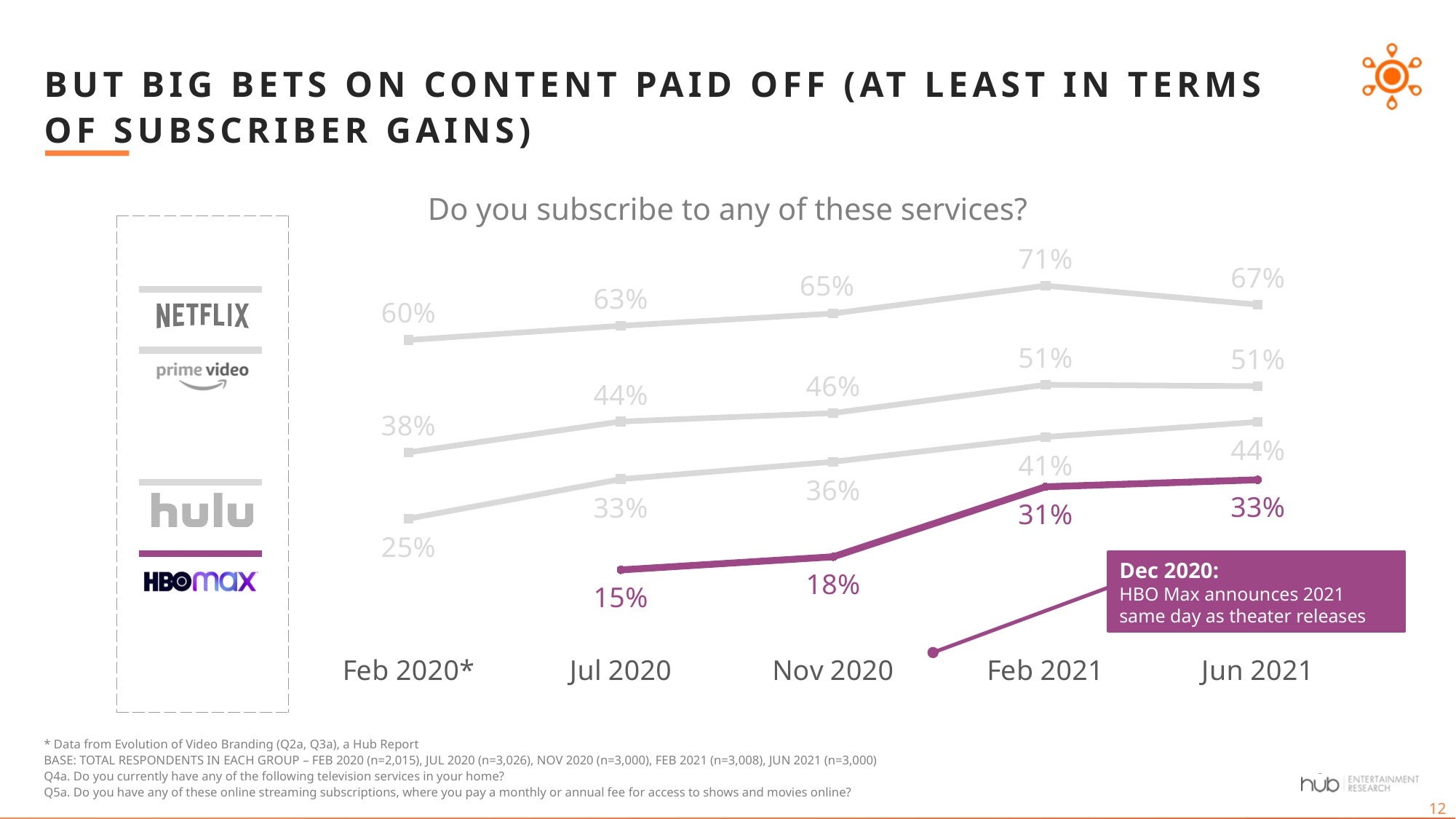
What kind of chart is shown on the slide? line chart What percentage of respondents subscribed to HBO Max in Jul 2020? 15% By how many percentage points did HBO Max's subscription rate increase from Nov 2020 to Feb 2021? 13 percentage points At which time point did Netflix reach its highest subscription rate? Feb 2021 How many services (series) does the legend on the left list? 4 How many time points are shown on the x axis of the chart? 5 What was the Netflix subscription rate in Feb 2021? 71% Which service had the lowest subscription rate in Jun 2021? HBO Max Which service had a higher subscription rate in Nov 2020, Prime Video or Hulu? Prime Video Does the Hulu line rise or fall from Feb 2020 to Jun 2021? rise What percentage of respondents subscribed to HBO Max in Jun 2021? 33% What was the Hulu subscription rate in Feb 2020? 25%